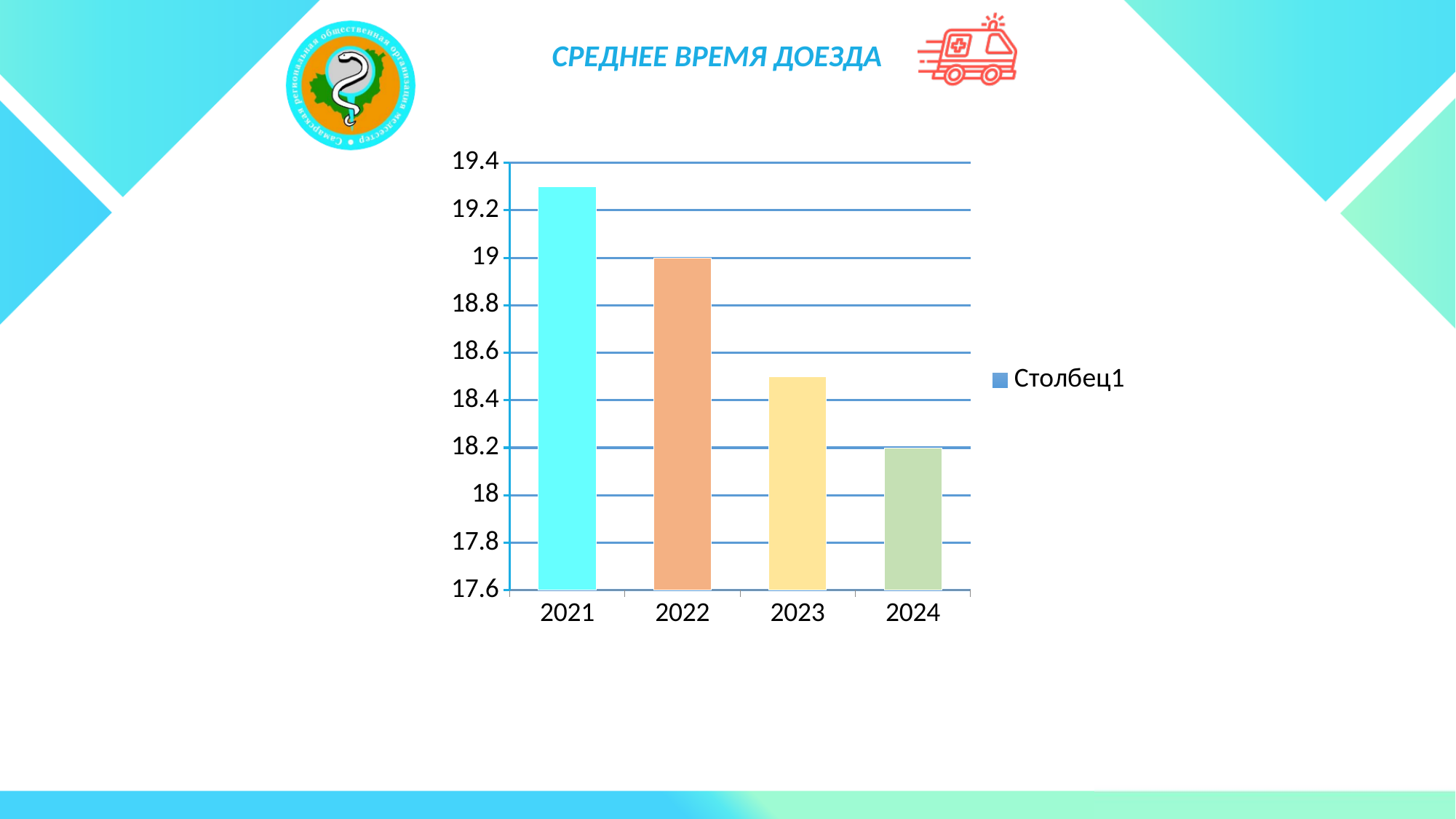
Which year has the highest value? 2021 What kind of chart is shown on the slide? bar chart How many series does the legend list? 1 How many years are shown on the x axis? 4 What is the value for 2022? 19 Which year has the lowest value? 2024 Which is larger, the value for 2022 or the value for 2023? 2022 What is the difference between the values for 2022 and 2024? 0.8 Is the value for 2023 greater or less than 18.6? less Is the value for 2021 greater or less than 19.2? greater Do the values rise or fall from 2021 to 2024? fall What is the value for 2024? 18.2